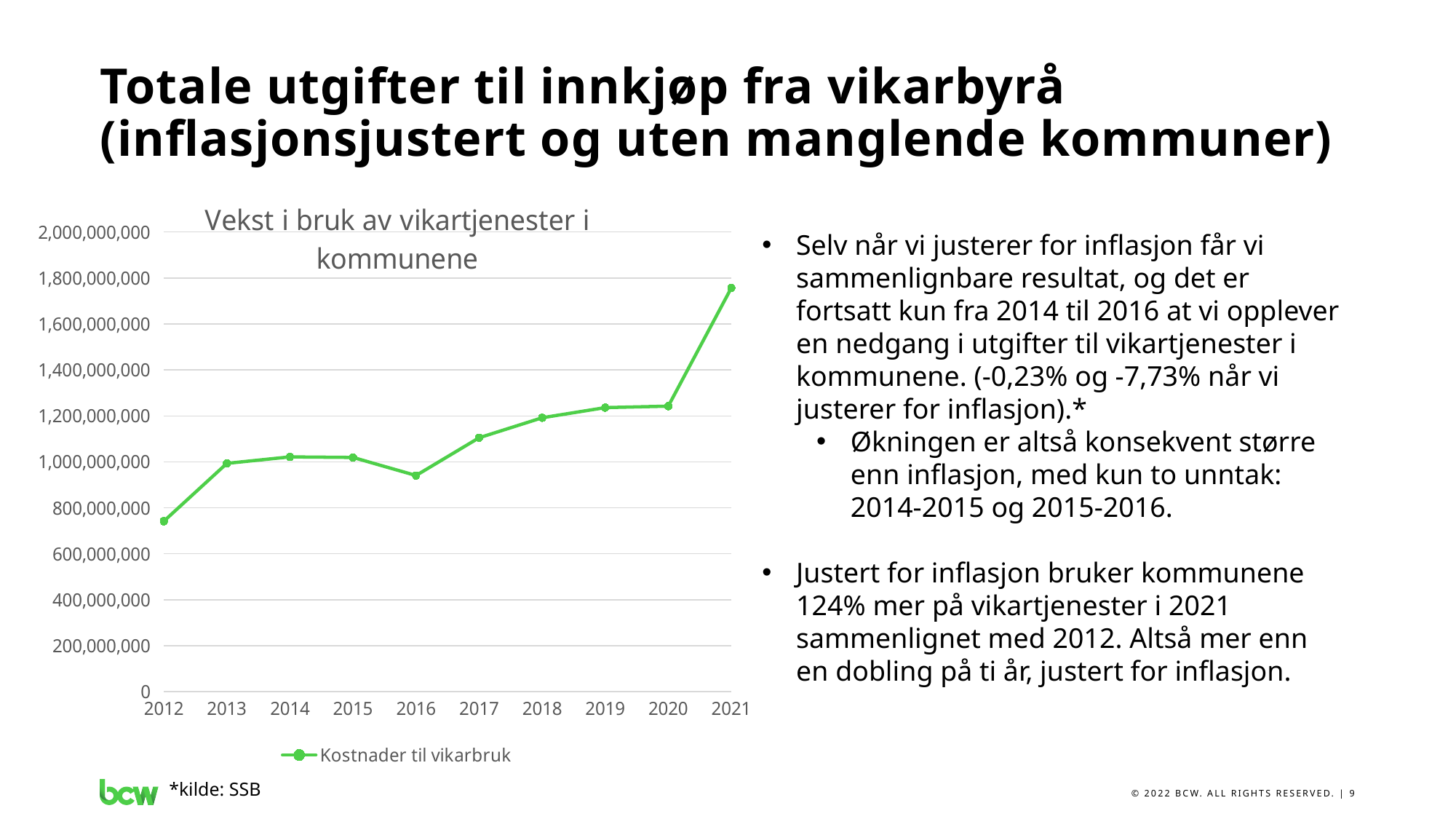
What is the title of the chart? Vekst i bruk av vikartjenester i kommunene Which year has the larger value, 2016 or 2017? 2017 Is the value for 2012 greater or less than 800,000,000? less What series name does the chart legend show? Kostnader til vikarbruk What kind of chart is shown on the slide? Line chart Is the value for 2021 greater or less than 1,600,000,000? greater Do the values generally rise or fall from 2012 to 2021? rise Which year has the highest value? 2021 How many series does the legend list? 1 Which year has the lowest value? 2012 Is the value for 2016 greater or less than 1,000,000,000? less How many years are plotted on the x axis? 10